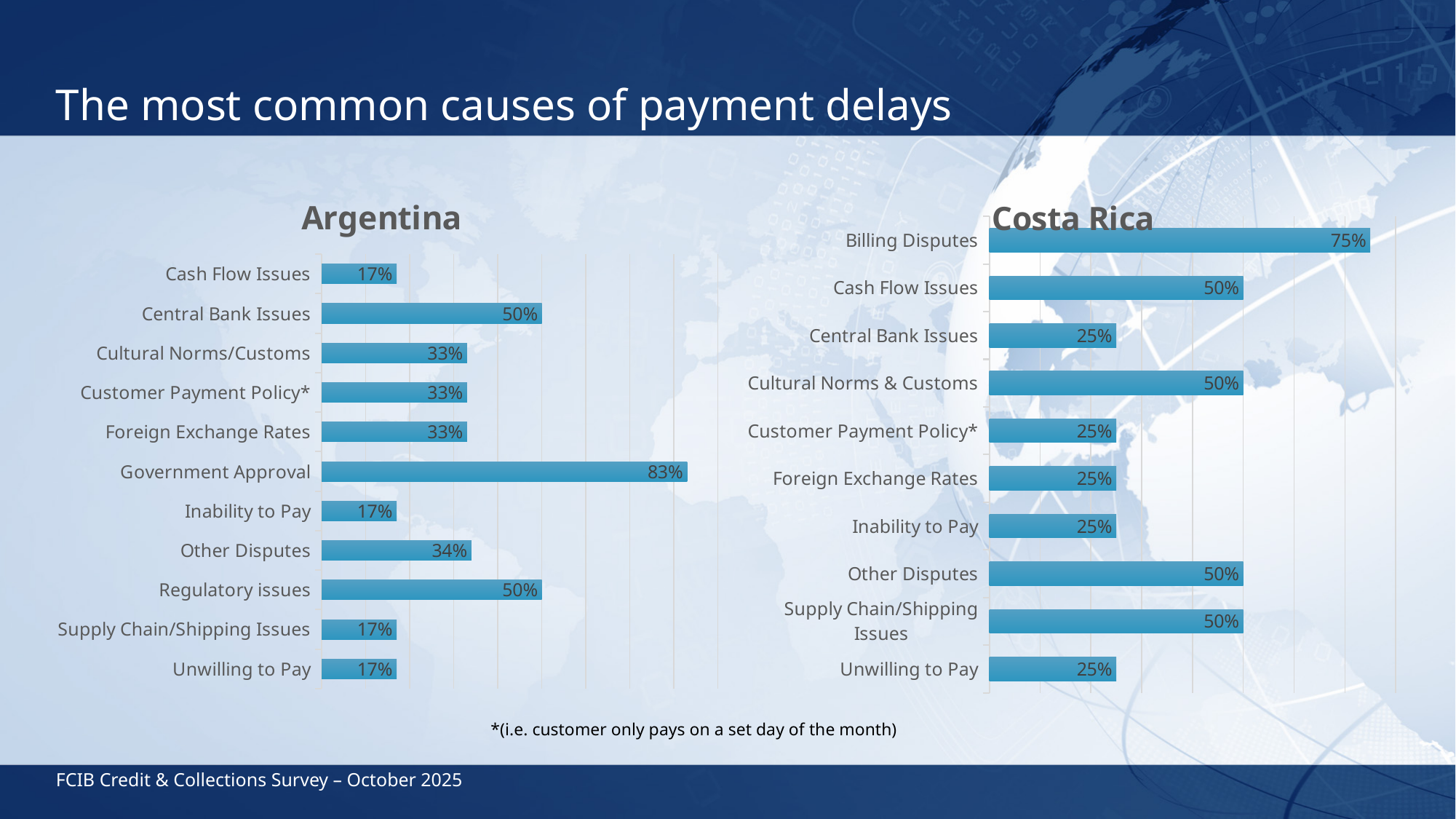
In the Costa Rica chart, what is the value for Unwilling to Pay? 25% In the Argentina chart, what is the value for Government Approval? 83% In the Costa Rica chart, which category has the highest value? Billing Disputes How many categories does the Costa Rica chart show? 10 In the Costa Rica chart, what is the value for Billing Disputes? 75% In the Argentina chart, what is the difference between Government Approval and Central Bank Issues? 33% In the Costa Rica chart, which is larger: Cash Flow Issues or Inability to Pay? Cash Flow Issues In the Costa Rica chart, what is the difference between Billing Disputes and Central Bank Issues? 50% In the Argentina chart, which category has the highest value? Government Approval What kind of chart is the Argentina chart? Bar chart In the Argentina chart, which is larger: Other Disputes or Cash Flow Issues? Other Disputes How many categories does the Argentina chart show? 11